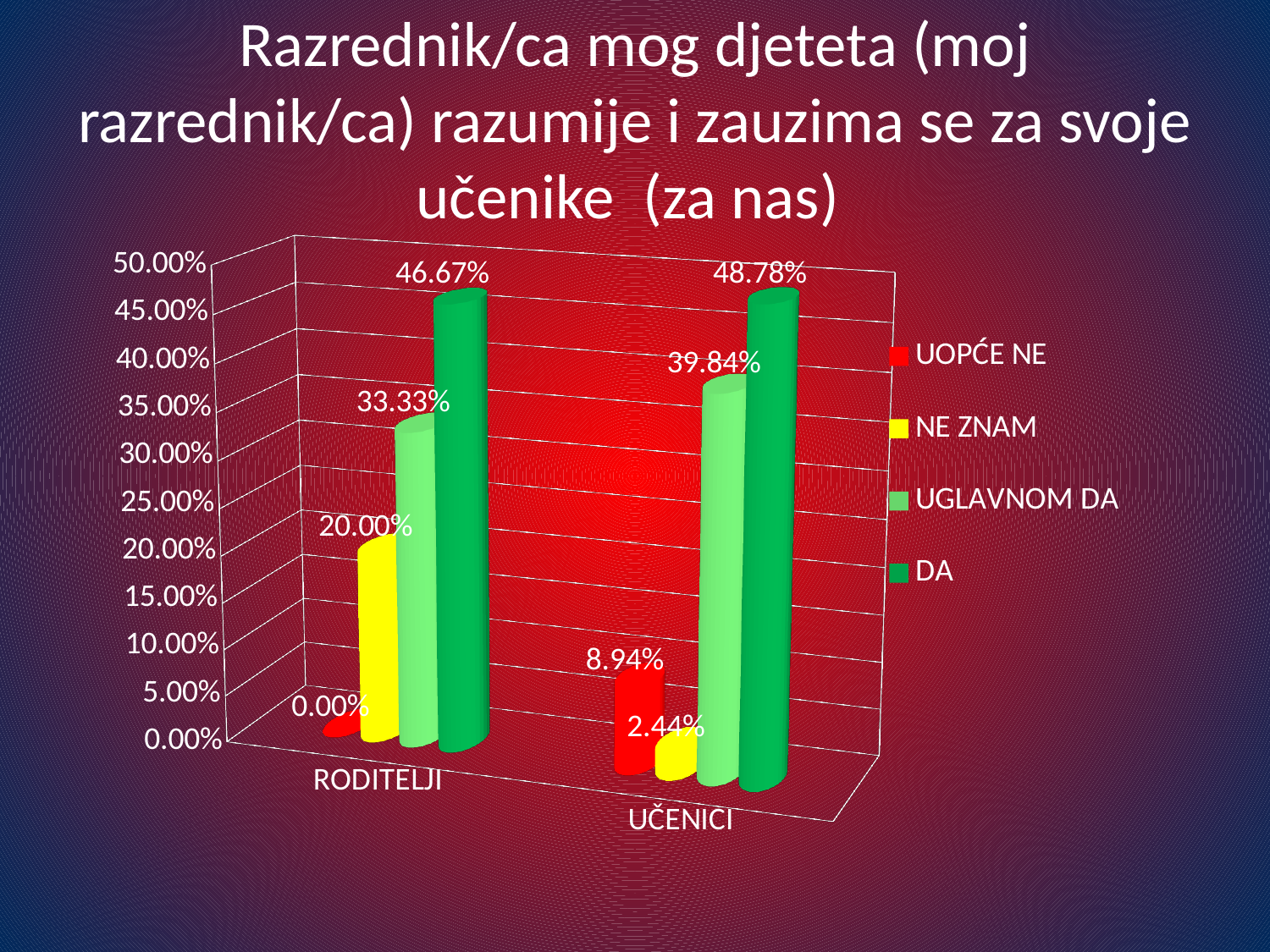
Which is larger: NE ZNAM for RODITELJI or NE ZNAM for UČENICI? RODITELJI How many series does the legend list? 4 Which series has the highest value in the UČENICI category? DA What is the value for NE ZNAM in the RODITELJI category? 20.00% How many categories are shown on the x axis? 2 Which series has the lowest value in the RODITELJI category? UOPĆE NE What is the value for UGLAVNOM DA in the UČENICI category? 39.84% What is the difference between the DA values for UČENICI and RODITELJI? 2.11% What kind of chart is shown on the slide? Bar chart What is the value for UOPĆE NE in the UČENICI category? 8.94% Which colour represents the DA series in the legend? Dark green What is the value for DA in the RODITELJI category? 46.67%